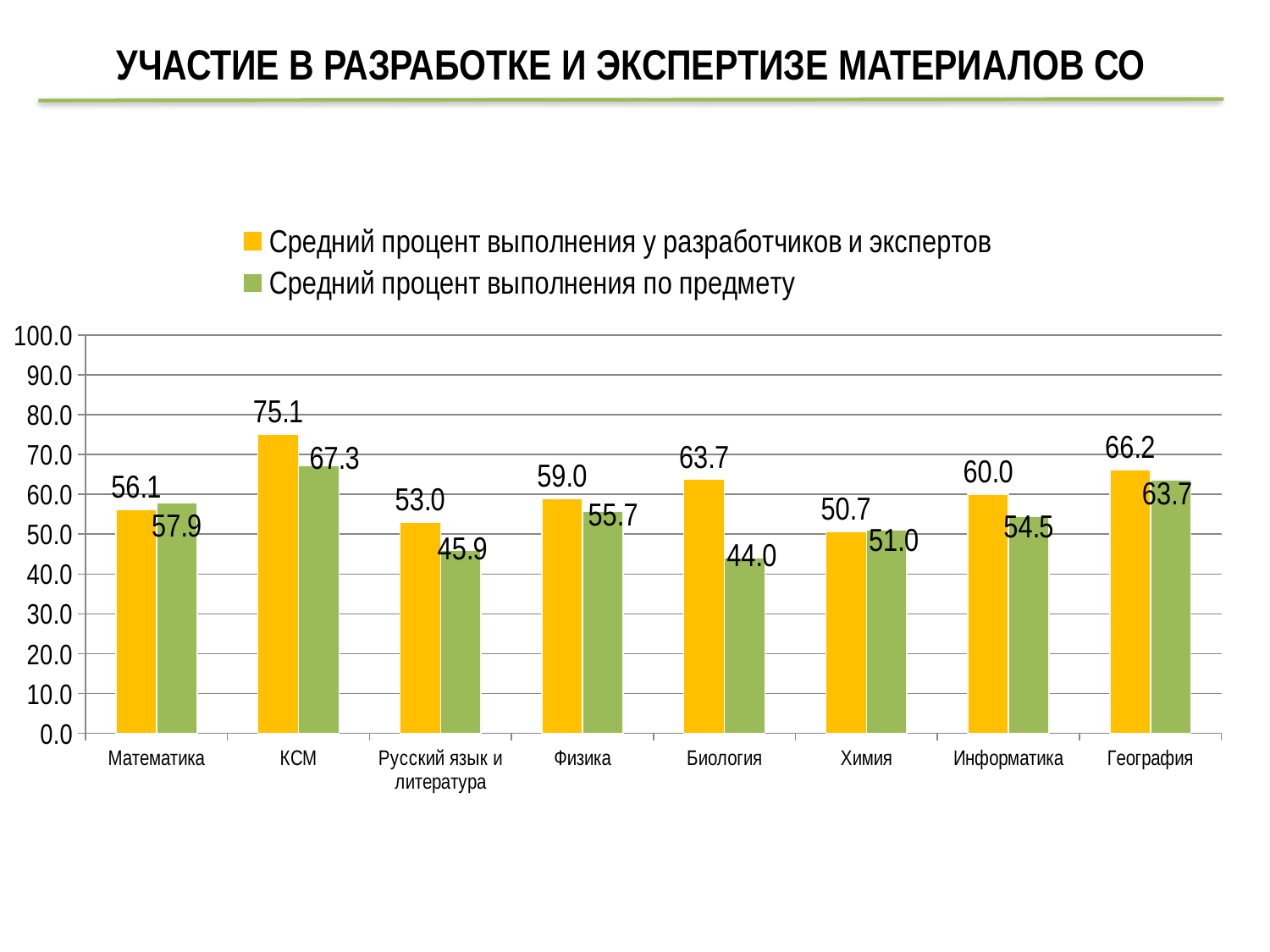
Which category has the highest value in the series 'Средний процент выполнения у разработчиков и экспертов'? КСМ For Математика, which series has the larger value? Средний процент выполнения по предмету What is the difference between the two series for Русский язык и литература? 7.1 Which category has the lowest value in the series 'Средний процент выполнения по предмету'? Биология What is the value for Биология in the series 'Средний процент выполнения по предмету'? 44.0 What is the value for КСМ in the series 'Средний процент выполнения у разработчиков и экспертов'? 75.1 What is the difference between the two series for Биология? 19.7 How many categories are shown on the x axis? 8 What colour are the bars for the series 'Средний процент выполнения по предмету'? Green What kind of chart is shown on the slide? Bar chart How many series does the legend list? 2 What is the value for Информатика in the series 'Средний процент выполнения по предмету'? 54.5